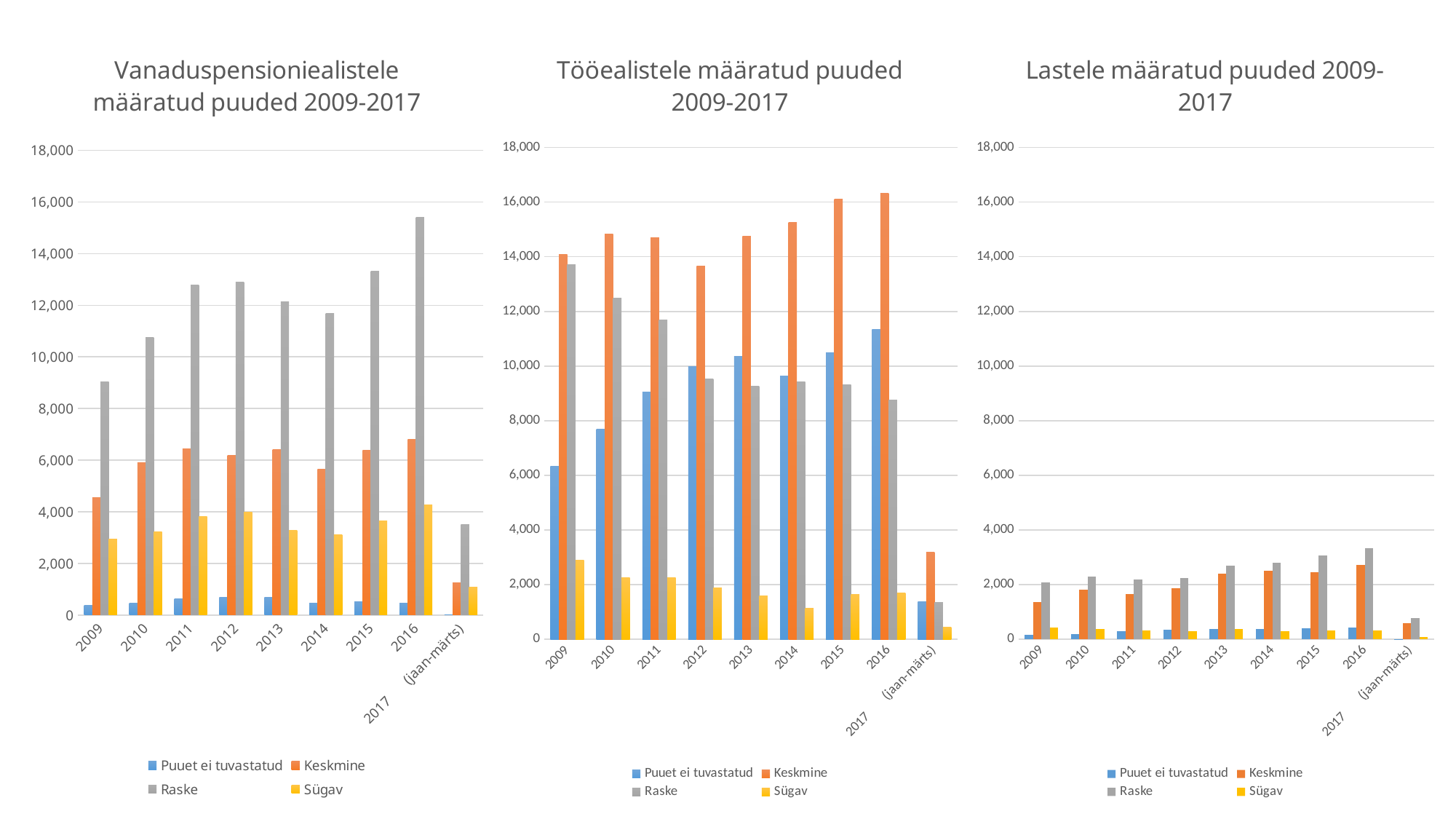
How many categories are shown on the x axis of the chart titled 'Lastele määratud puuded 2009-2017'? 9 In the chart titled 'Tööealistele määratud puuded 2009-2017', which is larger in 2009: Keskmine or Puuet ei tuvastatud? Keskmine How many series does the legend of the chart titled 'Tööealistele määratud puuded 2009-2017' list? 4 In the chart titled 'Tööealistele määratud puuded 2009-2017', which year has the tallest Keskmine bar? 2016 In the chart titled 'Vanaduspensioniealistele määratud puuded 2009-2017', is the Keskmine value for 2009 greater or less than 6,000? less In the chart titled 'Vanaduspensioniealistele määratud puuded 2009-2017', which year has the tallest Raske bar? 2016 How many charts are shown on the slide? 3 In the chart titled 'Vanaduspensioniealistele määratud puuded 2009-2017', is the Raske value for 2016 greater or less than 14,000? greater In the chart titled 'Lastele määratud puuded 2009-2017', is the Raske value for 2016 greater or less than 2,000? greater What kind of chart is the chart titled 'Lastele määratud puuded 2009-2017'? bar chart In the chart titled 'Tööealistele määratud puuded 2009-2017', does the Raske series rise or fall from 2009 to 2016? fall